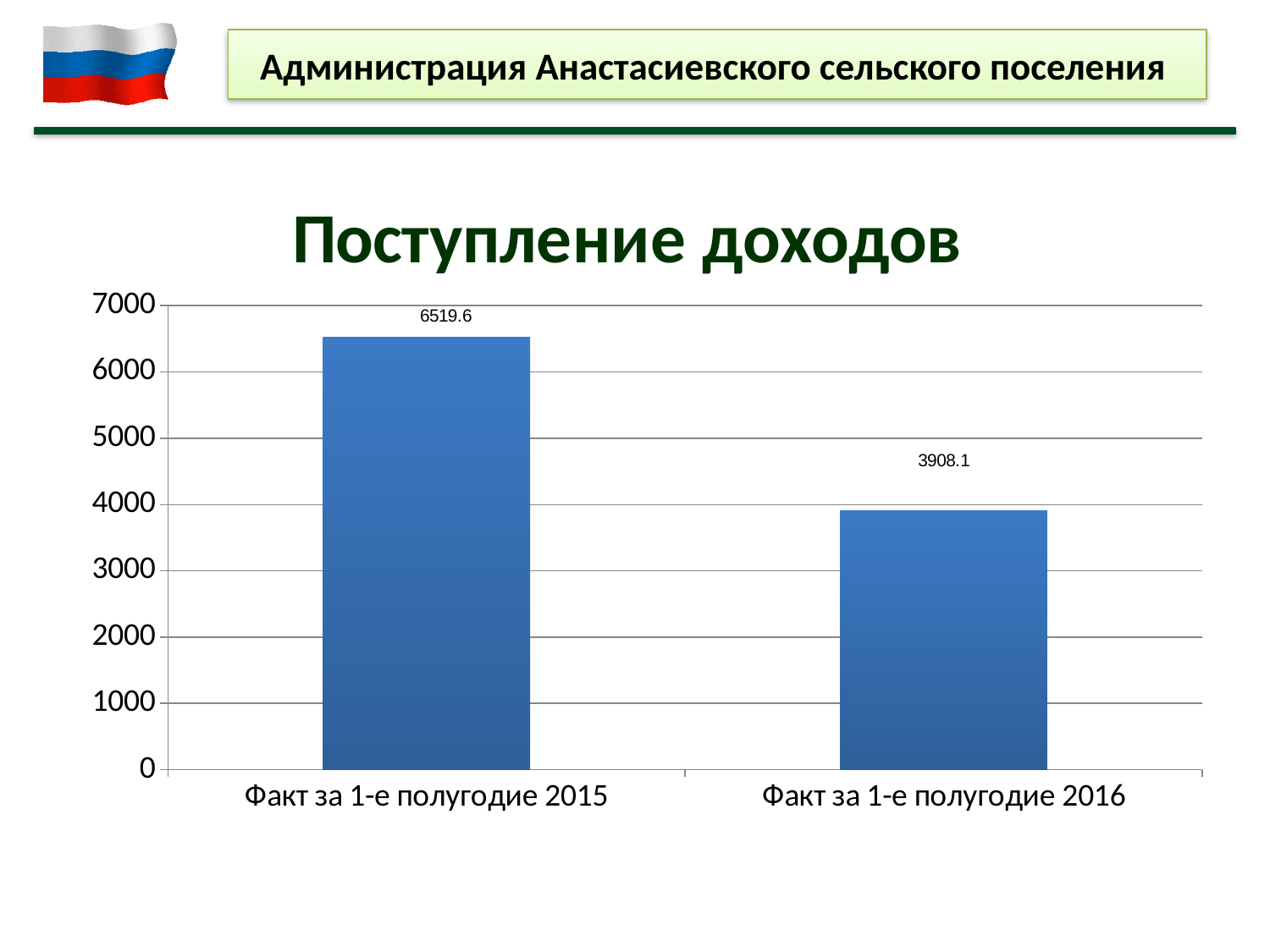
Which is larger: the value for Факт за 1-е полугодие 2015 or for Факт за 1-е полугодие 2016? Факт за 1-е полугодие 2015 Do the values rise or fall from the 2015 category to the 2016 category? fall How many categories are shown on the chart? 2 What is the difference between the values for Факт за 1-е полугодие 2015 and Факт за 1-е полугодие 2016? 2611.5 What is the value for Факт за 1-е полугодие 2015? 6519.6 What is the value for Факт за 1-е полугодие 2016? 3908.1 Which category has the highest value? Факт за 1-е полугодие 2015 Is the value for Факт за 1-е полугодие 2016 greater or less than 4000? less Which category has the lowest value? Факт за 1-е полугодие 2016 Is the value for Факт за 1-е полугодие 2015 greater or less than 6000? greater What kind of chart is shown on the slide? bar chart What is the title of the chart? Поступление доходов